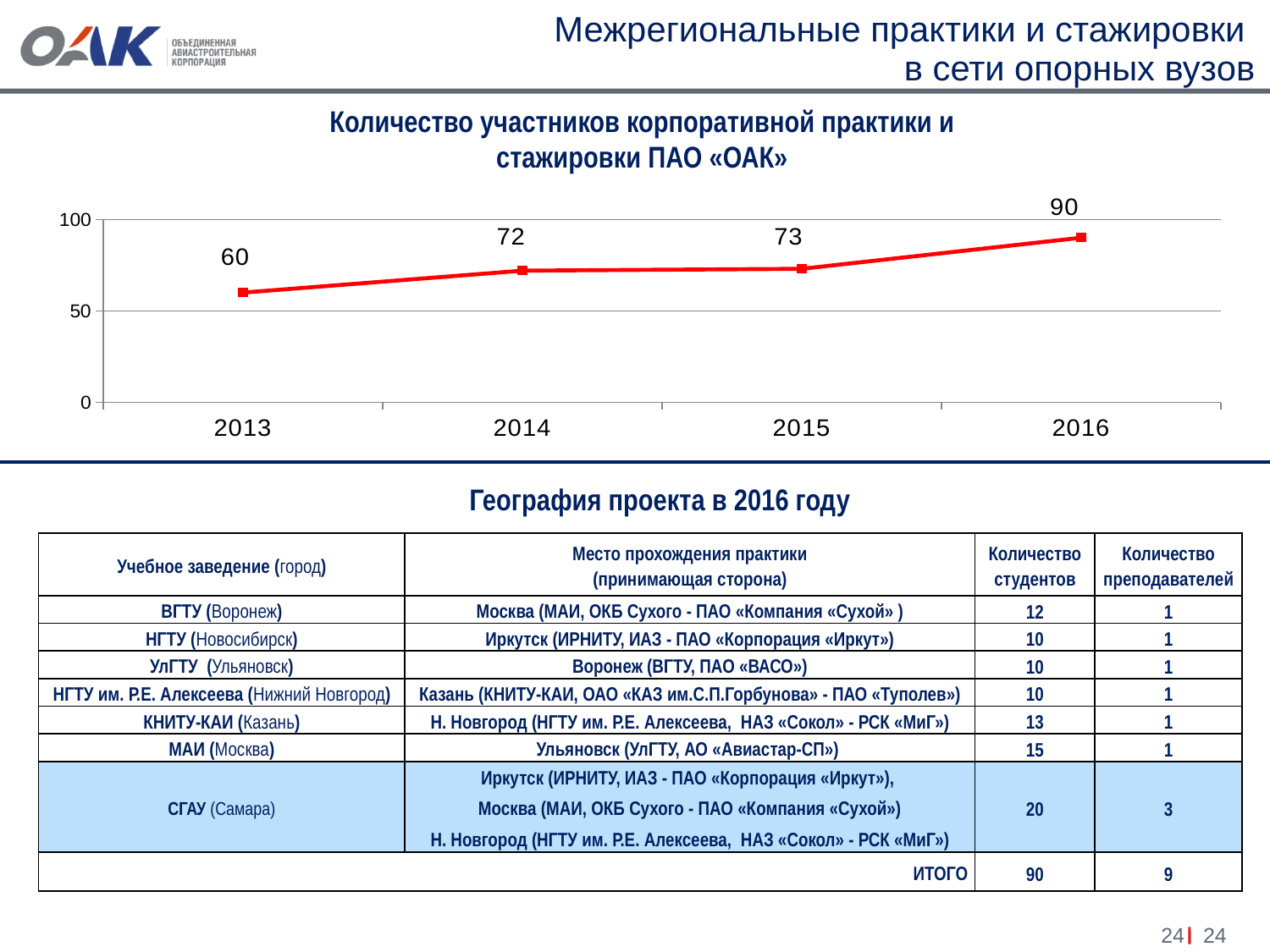
Do the values rise or fall from 2013 to 2016? rise What is the value for 2013 in the chart? 60 What kind of chart is shown on the slide? line chart Which is larger, the value for 2016 or the value for 2014? 2016 What is the value for 2015 in the chart? 73 What is the value for 2016 in the chart? 90 What is the difference between the values for 2014 and 2013? 12 How many years are plotted in the chart? 4 What is the difference between the values for 2016 and 2013? 30 What is the value for 2014 in the chart? 72 Which year has the highest value in the chart? 2016 Which year has the lowest value in the chart? 2013